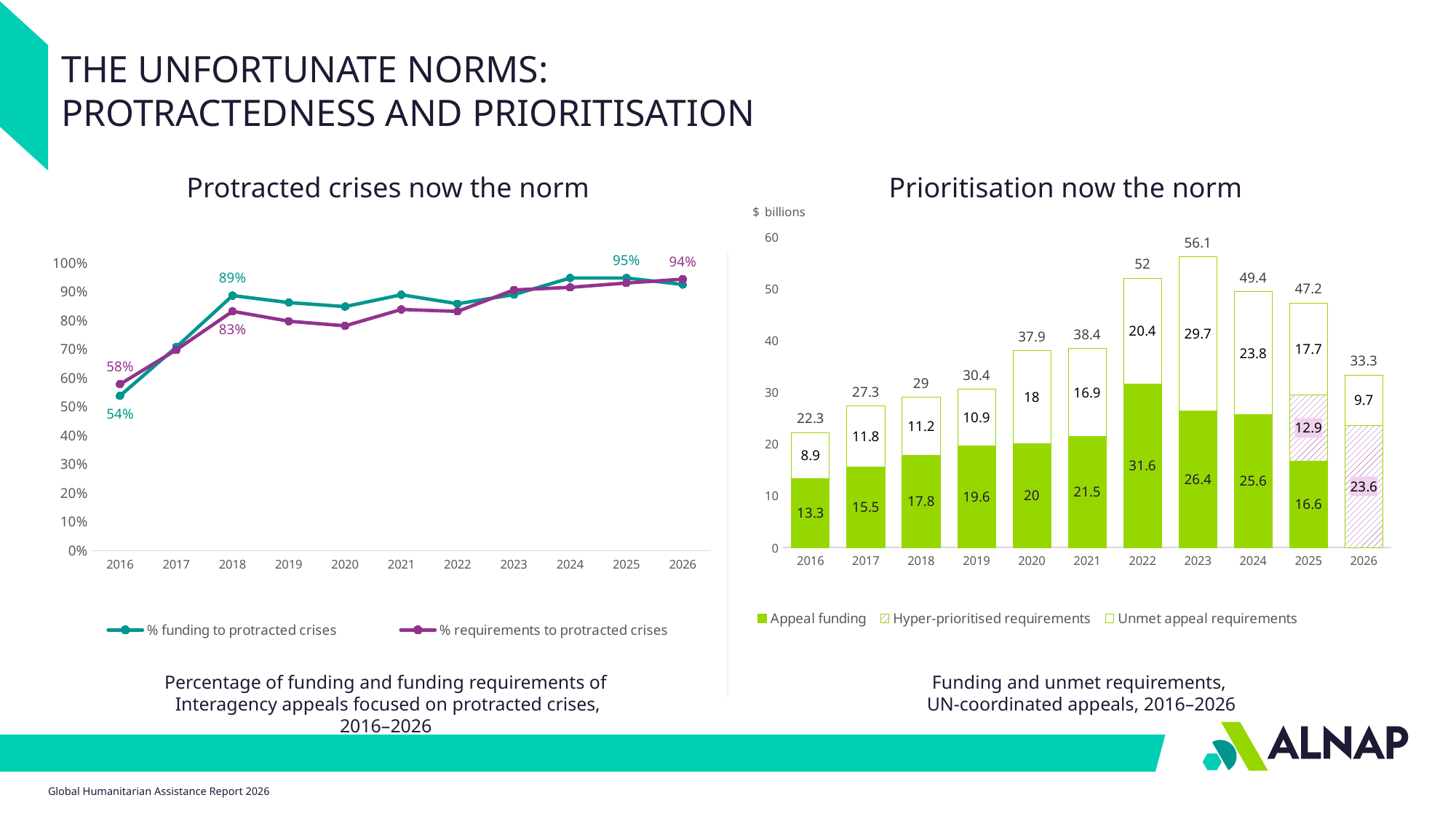
In the 'Prioritisation now the norm' chart, which year has the highest total bar? 2023 In the 'Protracted crises now the norm' chart, what is the value of % requirements to protracted crises in 2018? 83% In the 'Prioritisation now the norm' chart, which year has the lowest total bar? 2016 In the 'Protracted crises now the norm' chart, what kind of chart is shown? Line chart In the 'Protracted crises now the norm' chart, how many series does the legend list? 2 In the 'Protracted crises now the norm' chart, what is the value of % funding to protracted crises in 2016? 54% In the 'Prioritisation now the norm' chart, what is the Appeal funding value for 2022? 31.6 In the 'Prioritisation now the norm' chart, how many years are shown on the x axis? 11 In the 'Protracted crises now the norm' chart, what is the value of % funding to protracted crises in 2025? 95% In the 'Prioritisation now the norm' chart, what is the total of the stacked bar for 2023? 56.1 In the 'Protracted crises now the norm' chart, is the value of % funding to protracted crises in 2020 greater or less than 80%? greater In the 'Prioritisation now the norm' chart, what is the difference between the Unmet appeal requirements values for 2023 and 2024? 5.9